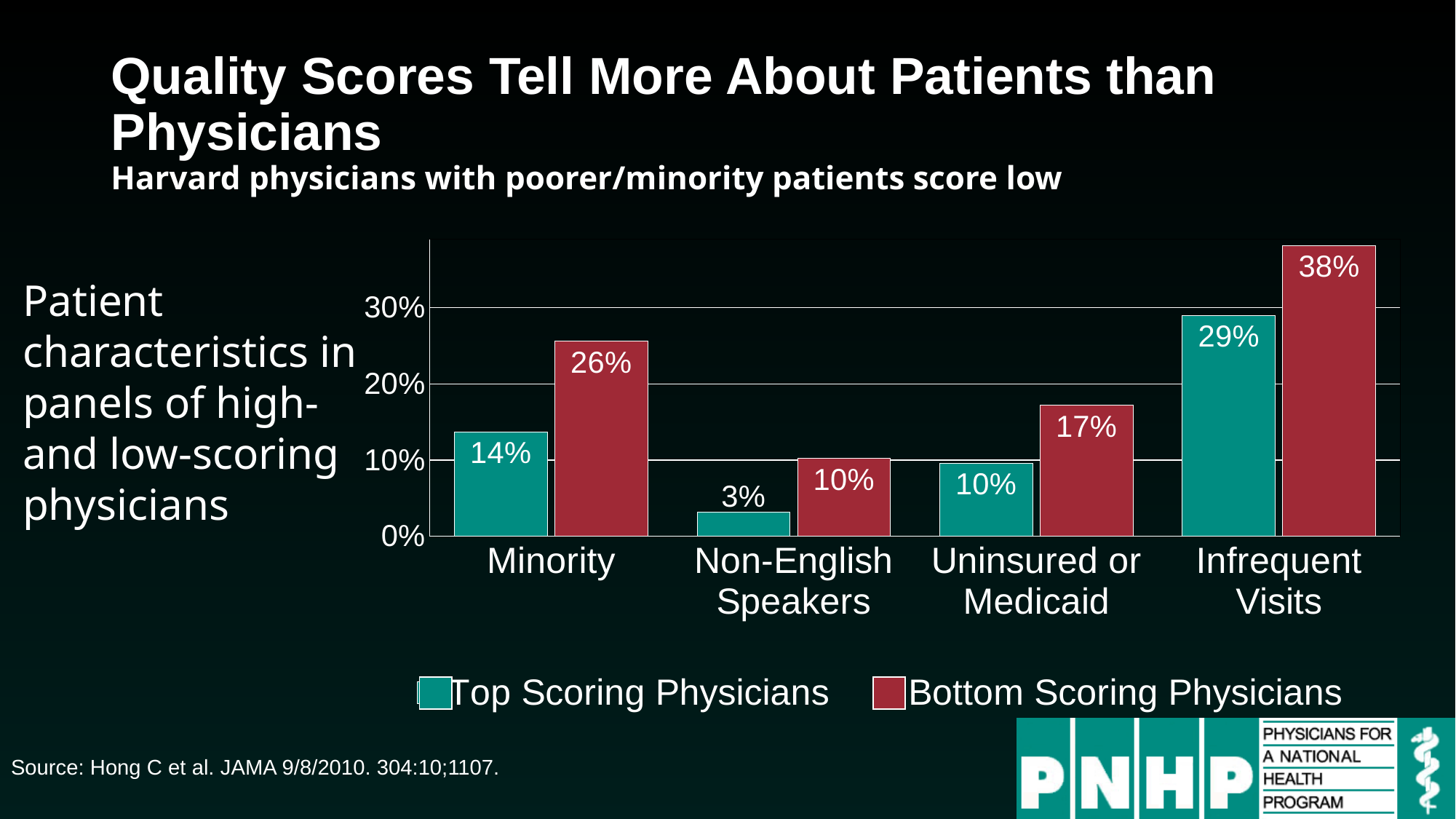
What is the value for Top Scoring Physicians in the Uninsured or Medicaid category? 10% What is the value for Bottom Scoring Physicians in the Minority category? 26% What is the value for Bottom Scoring Physicians in the Infrequent Visits category? 38% What is the value for Top Scoring Physicians in the Non-English Speakers category? 3% In the Uninsured or Medicaid category, which series has the larger value? Bottom Scoring Physicians What colour are the bars for Top Scoring Physicians? Teal Which category has the lowest value for Bottom Scoring Physicians? Non-English Speakers What is the difference between Bottom Scoring Physicians and Top Scoring Physicians in the Minority category? 12% How many categories are shown on the x axis? 4 What kind of chart is shown on the slide? Bar chart Which category has the highest value for Top Scoring Physicians? Infrequent Visits How many series does the legend list? 2